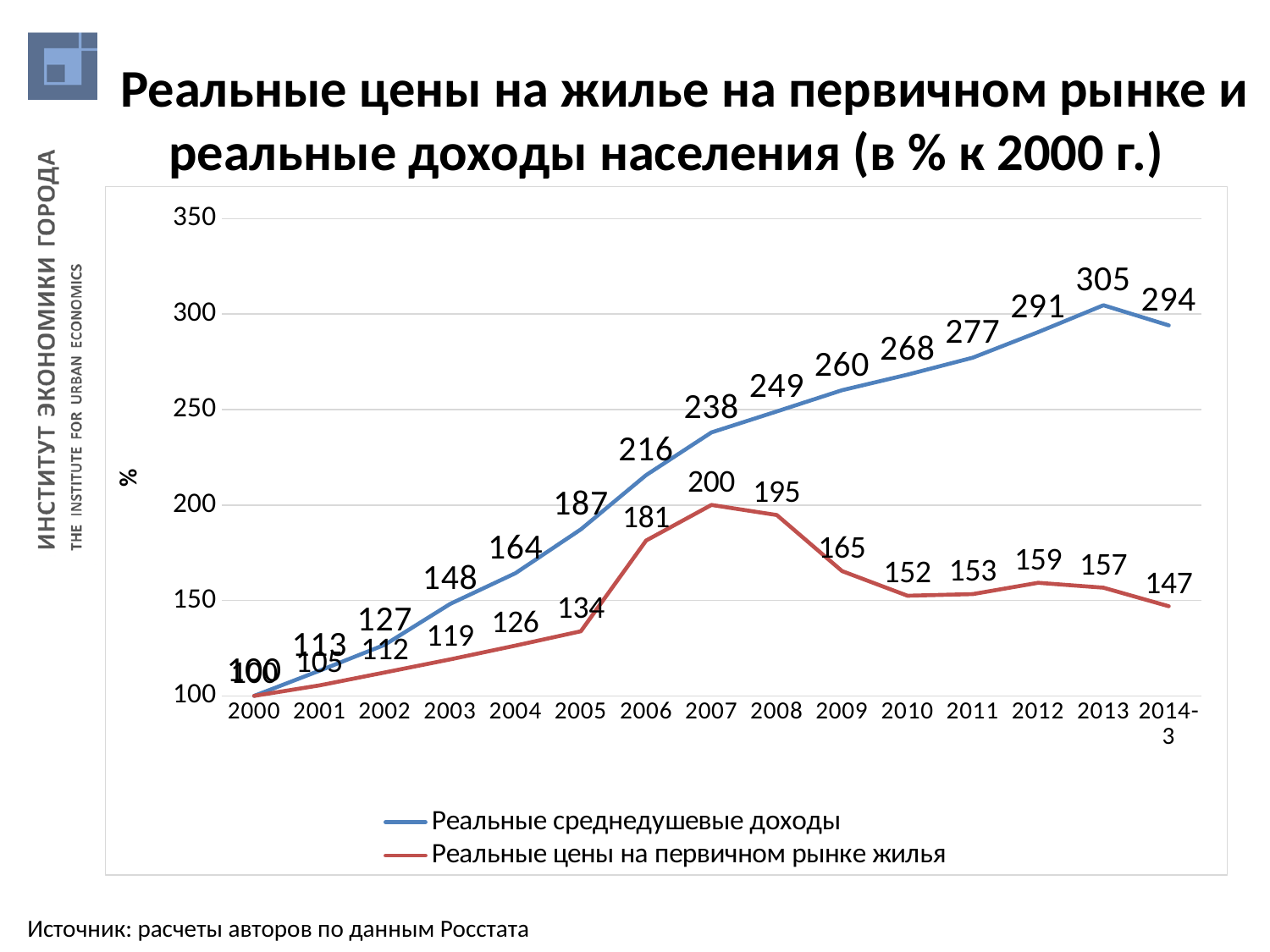
In which year does Реальные цены на первичном рынке жилья reach its highest value? 2007 What is the value of Реальные среднедушевые доходы in 2007? 238 What colour is the line for Реальные цены на первичном рынке жилья? Red Which series has the larger value in 2006: Реальные среднедушевые доходы or Реальные цены на первичном рынке жилья? Реальные среднедушевые доходы How many years (x-axis categories) are plotted on the chart? 15 What is the value of Реальные цены на первичном рынке жилья in 2009? 165 In which year does Реальные среднедушевые доходы reach its highest value? 2013 What is the difference between Реальные среднедушевые доходы and Реальные цены на первичном рынке жилья in 2014-3? 147 Does Реальные цены на первичном рынке жилья rise or fall from 2007 to 2010? Fall How many series does the legend list? 2 What is the difference between the 2013 and 2014-3 values of Реальные среднедушевые доходы? 11 What kind of chart is shown on the slide? Line chart